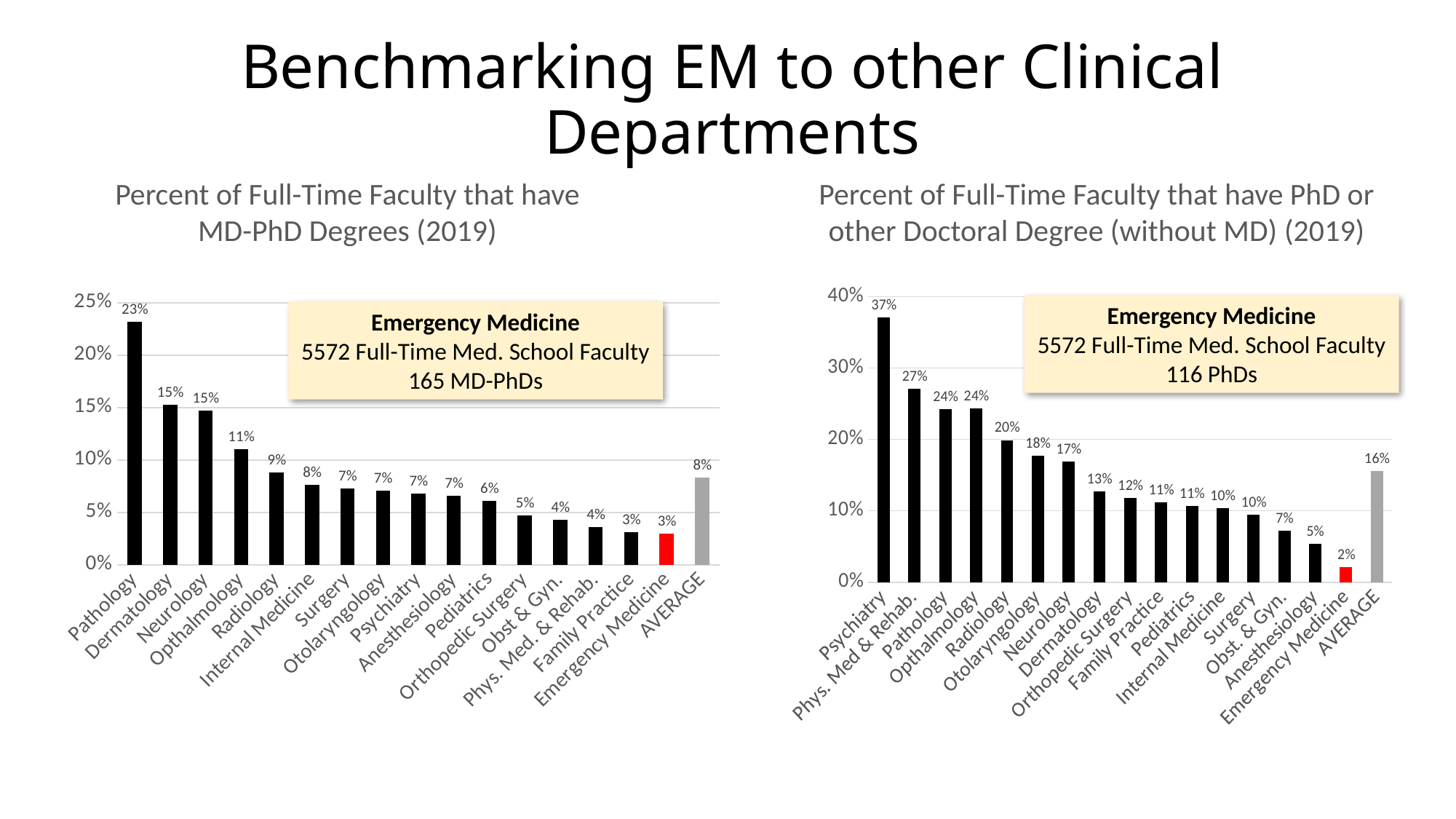
In the left chart (MD-PhD Degrees), which department has the highest value? Pathology In the left chart (MD-PhD Degrees), what is the value for Emergency Medicine? 3% What type of chart is the left chart (MD-PhD Degrees)? Bar chart In the right chart (PhD or other Doctoral Degree), what is the value for Emergency Medicine? 2% In the left chart (MD-PhD Degrees), what is the value for Pathology? 23% In the right chart (PhD or other Doctoral Degree), what is the difference between AVERAGE and Emergency Medicine? 14% In the right chart (PhD or other Doctoral Degree), what is the value for Psychiatry? 37% In the right chart (PhD or other Doctoral Degree), which is larger, Radiology or Dermatology? Radiology In the left chart (MD-PhD Degrees), what is the difference between Pathology and Emergency Medicine? 20% How many bars are plotted in the right chart (PhD or other Doctoral Degree)? 17 In the left chart (MD-PhD Degrees), what is the value for AVERAGE? 8% In the right chart (PhD or other Doctoral Degree), which department has the lowest value? Emergency Medicine